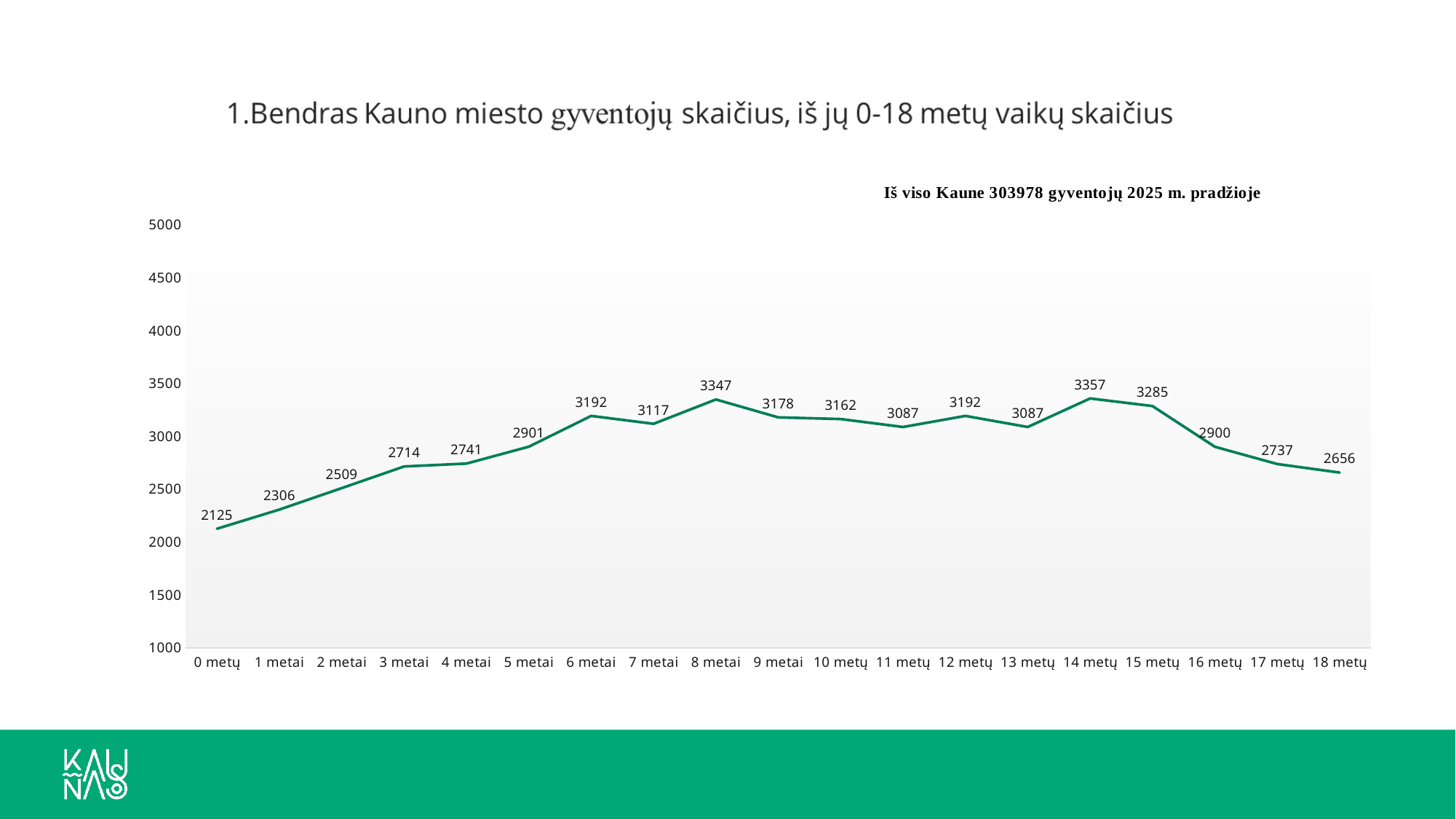
What is the value for 18 metų? 2656 What is the value for 12 metų? 3192 Which age category has the highest value? 14 metų Which is larger, the value for 3 metai or the value for 16 metų? 16 metų What total number of Kaunas residents at the start of 2025 is stated on the slide? 303978 Which age category has the lowest value? 0 metų What is the value for 8 metai? 3347 Do the values rise or fall from 0 metų to 6 metai? rise What is the value for 0 metų? 2125 What is the difference between the values for 14 metų and 0 metų? 1232 What kind of chart is shown on the slide? line chart How many age categories are plotted on the x axis? 19